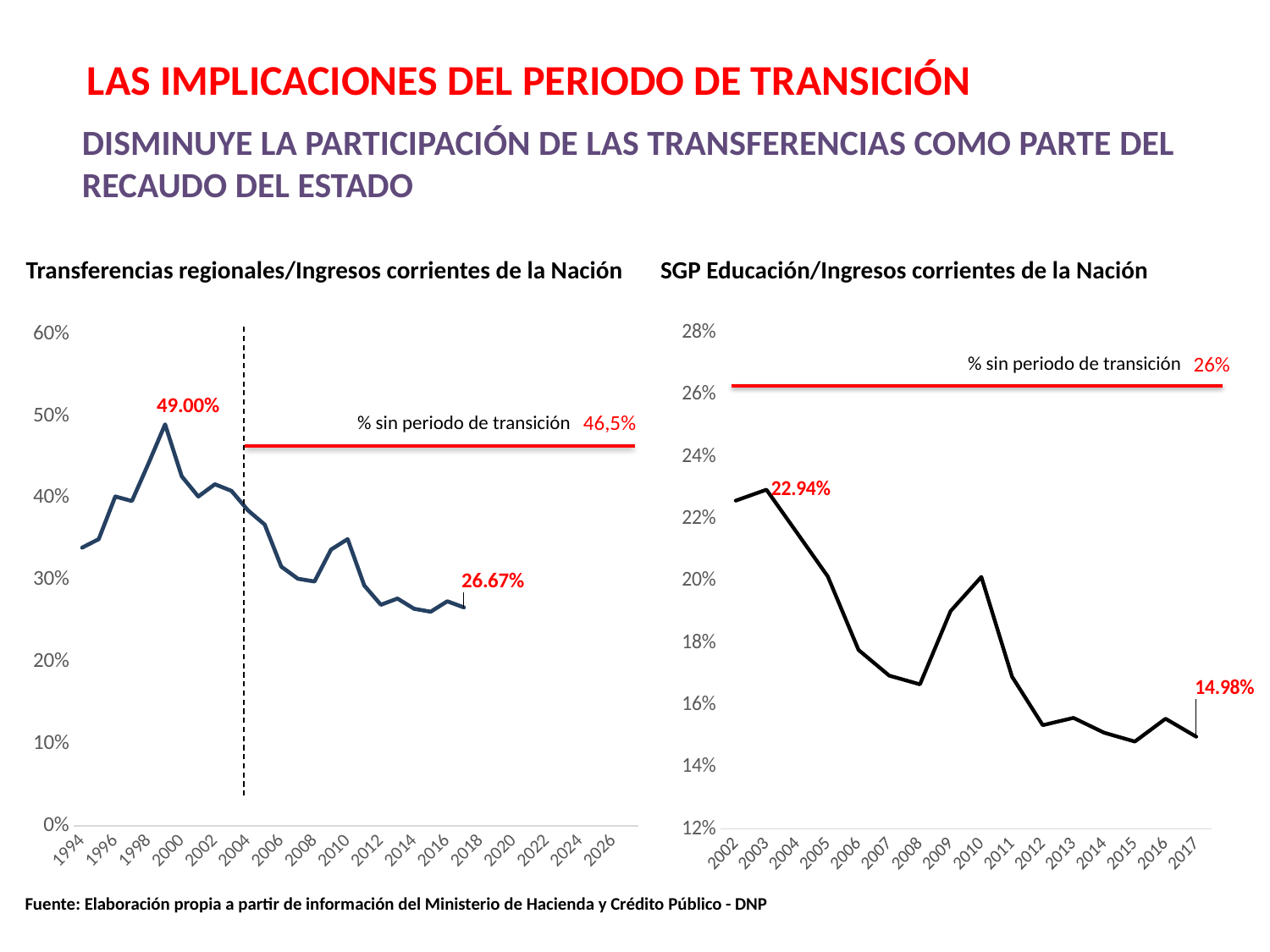
In the left chart (Transferencias regionales/Ingresos corrientes de la Nación), does the line generally rise or fall after its peak? fall In the left chart (Transferencias regionales/Ingresos corrientes de la Nación), what is the difference between the labeled peak value and the labeled final value? 22.33% In the left chart (Transferencias regionales/Ingresos corrientes de la Nación), what value is labeled at the end of the line? 26.67% In the left chart (Transferencias regionales/Ingresos corrientes de la Nación), what value is shown for the red '% sin periodo de transición' line? 46,5% In the left chart (Transferencias regionales/Ingresos corrientes de la Nación), is the value for 1994 greater or less than 40%? less What type of chart is the left chart titled 'Transferencias regionales/Ingresos corrientes de la Nación'? line chart In the right chart (SGP Educación/Ingresos corrientes de la Nación), what value is shown for the red '% sin periodo de transición' line? 26% In the left chart (Transferencias regionales/Ingresos corrientes de la Nación), what is the peak value labeled on the line? 49.00% In the right chart (SGP Educación/Ingresos corrientes de la Nación), what is the difference between the value labeled near 2003 and the value labeled for 2017? 7.96% In the right chart (SGP Educación/Ingresos corrientes de la Nación), what value is labeled for 2017? 14.98% In the right chart (SGP Educación/Ingresos corrientes de la Nación), what value is labeled near 2003? 22.94% In the right chart (SGP Educación/Ingresos corrientes de la Nación), is the value for 2010 greater or less than 18%? greater